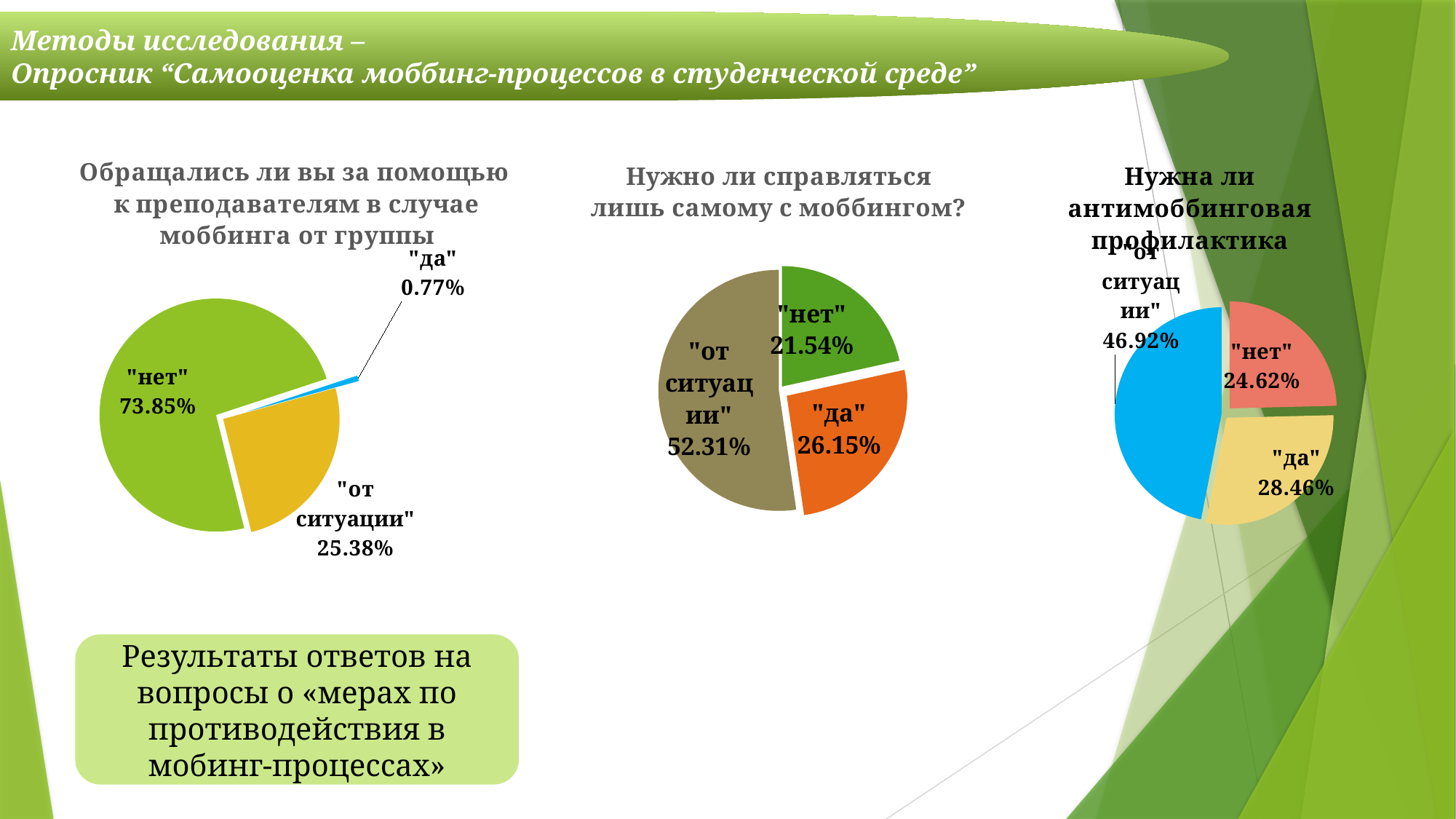
In the left chart ("Обращались ли вы за помощью к преподавателям..."), which answer has the smallest slice? "да" In the left chart ("Обращались ли вы за помощью к преподавателям..."), what share of respondents answered "да"? 0.77% In the left chart ("Обращались ли вы за помощью к преподавателям..."), what is the difference between the "нет" and "от ситуации" shares? 48.47% In the middle chart ("Нужно ли справляться лишь самому с моббингом?"), which is larger, the "да" share or the "нет" share? "да" In the left chart ("Обращались ли вы за помощью к преподавателям в случае моббинга от группы"), what share of respondents answered "нет"? 73.85% In the middle chart ("Нужно ли справляться лишь самому с моббингом?"), which answer has the largest slice? "от ситуации" In the right chart ("Нужна ли антимоббинговая профилактика"), which answer has the largest slice? "от ситуации" What type of chart is used for the middle chart ("Нужно ли справляться лишь самому с моббингом?")? Pie chart In the middle chart ("Нужно ли справляться лишь самому с моббингом?"), what is the difference between the "да" and "нет" shares? 4.61% How many slices does the right chart ("Нужна ли антимоббинговая профилактика") have? 3 In the middle chart ("Нужно ли справляться лишь самому с моббингом?"), what share of respondents answered "от ситуации"? 52.31% In the right chart ("Нужна ли антимоббинговая профилактика"), what share of respondents answered "да"? 28.46%